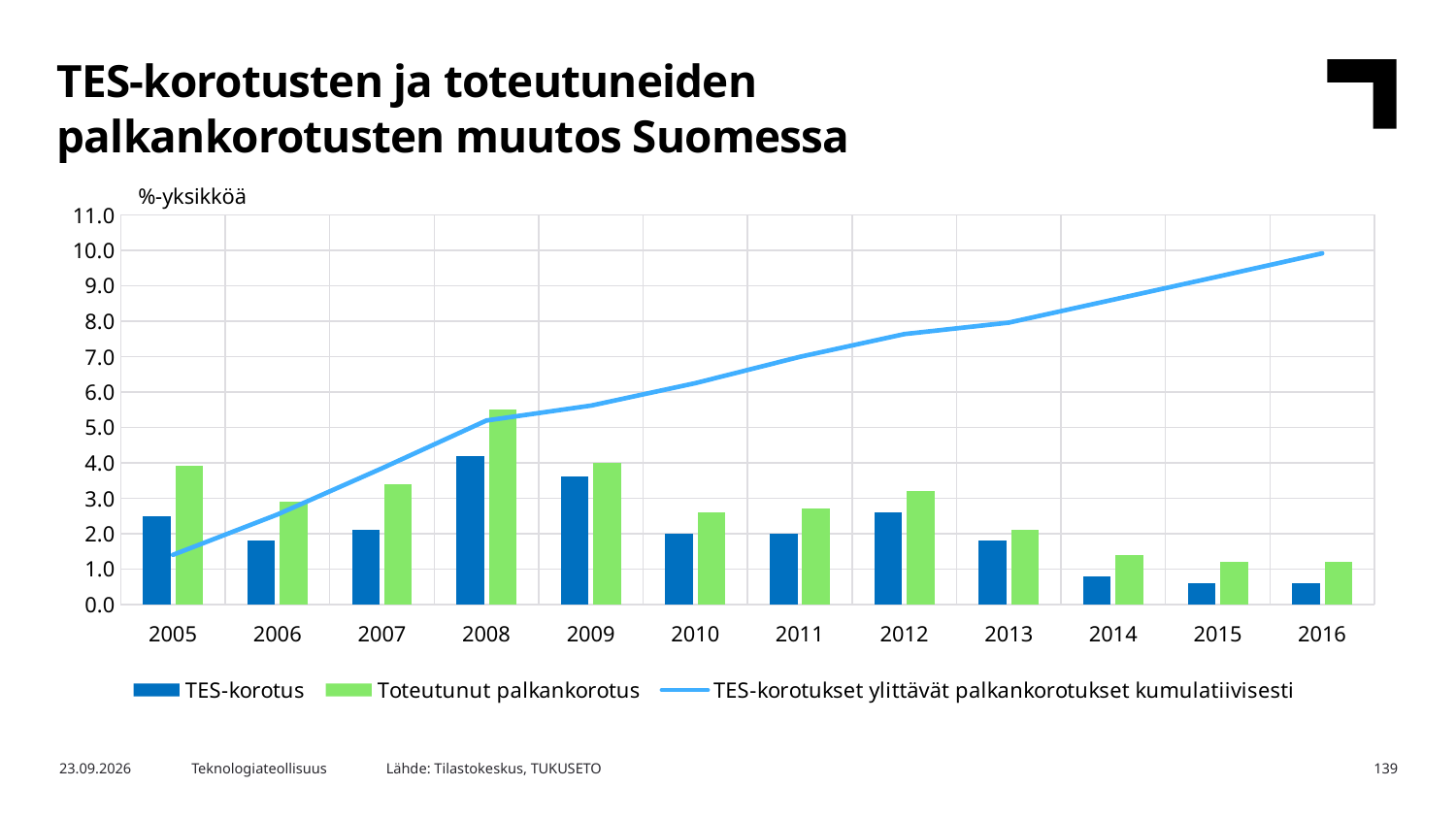
What unit label is shown above the y axis? %-yksikköä In which year is the TES-korotus bar highest? 2008 Which is larger, the TES-korotus value for 2005 or for 2006? 2005 How many series does the legend list? 3 Does the line 'TES-korotukset ylittävät palkankorotukset kumulatiivisesti' rise or fall from 2005 to 2016? rise In which year is the Toteutunut palkankorotus bar highest? 2008 Is the value of the line 'TES-korotukset ylittävät palkankorotukset kumulatiivisesti' in 2005 greater or less than 2.0? less Is the value of the line 'TES-korotukset ylittävät palkankorotukset kumulatiivisesti' in 2016 greater or less than 9.0? greater How many years are shown on the x axis? 12 Is the TES-korotus value for 2014 greater or less than 1.0? less What kind of chart is this? A combined bar and line chart